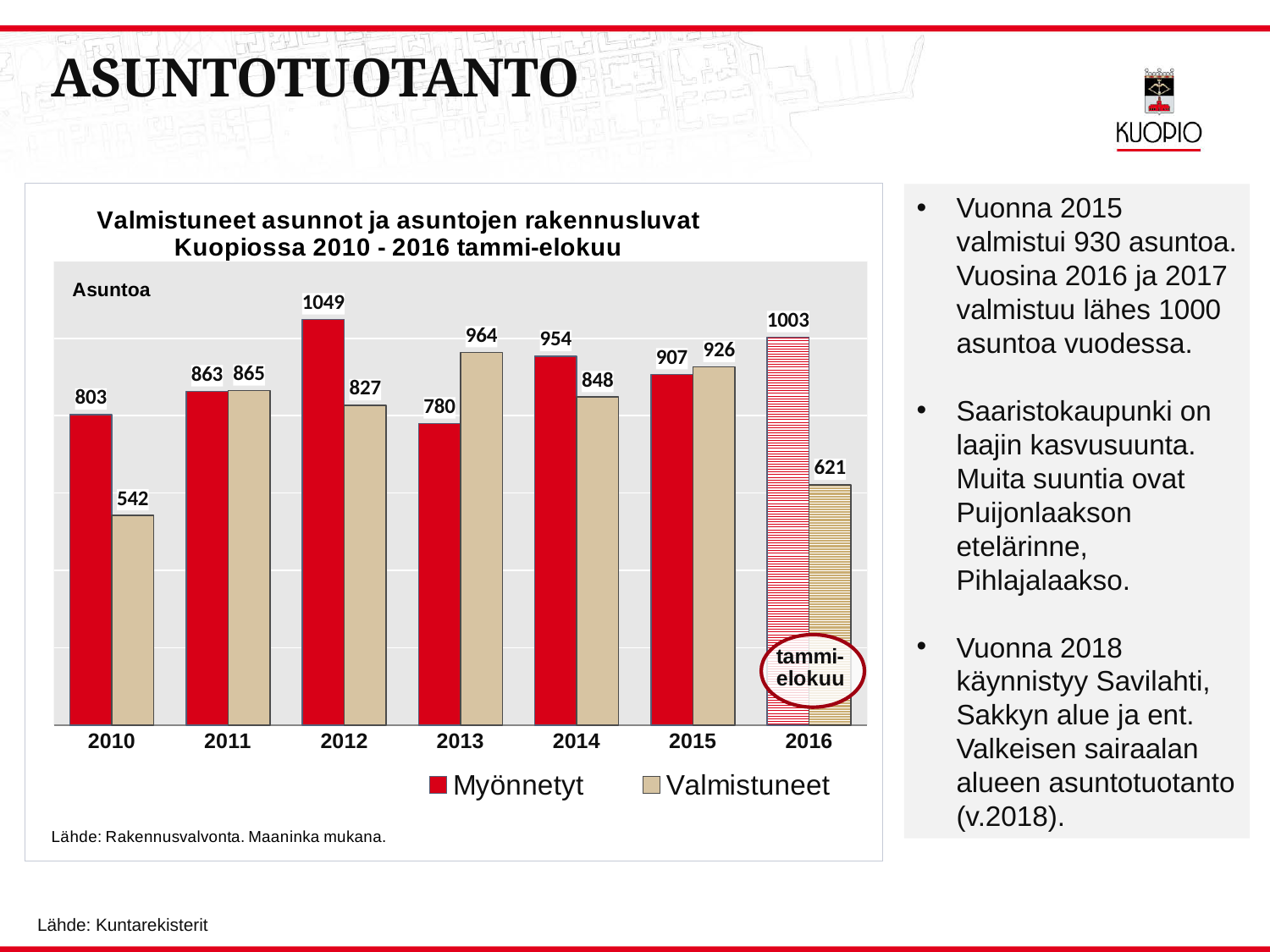
What is the title of the chart? Valmistuneet asunnot ja asuntojen rakennusluvat Kuopiossa 2010 - 2016 tammi-elokuu Which year has the lowest Myönnetyt value? 2013 What is the difference between Myönnetyt and Valmistuneet in 2010? 261 How many series does the legend list? 2 What is the value for Valmistuneet in 2016 (tammi-elokuu)? 621 What is the value for Myönnetyt in 2012? 1049 What is the difference between the Myönnetyt values for 2012 and 2013? 269 What is the value for Valmistuneet in 2010? 542 Which is larger in 2014, Myönnetyt or Valmistuneet? Myönnetyt Which year has the highest Valmistuneet value? 2013 What kind of chart is shown? bar chart How many years are shown on the x axis? 7